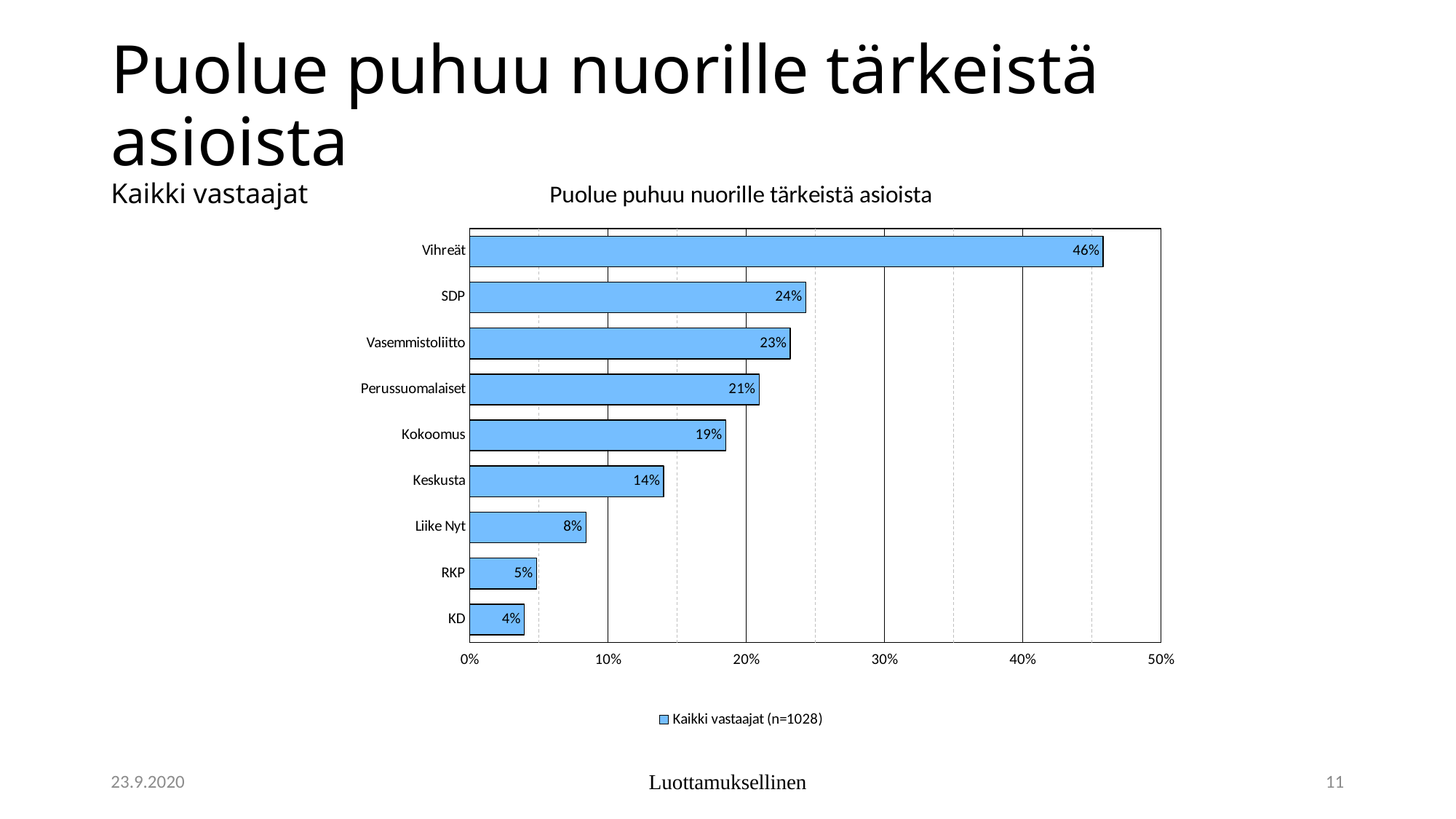
What is the value for Kokoomus? 19% What is the value for Vihreät? 46% What is the difference between the values for SDP and Keskusta? 10% Which party has the highest value? Vihreät What kind of chart is shown on the slide? Bar chart Is the value for Vasemmistoliitto greater or less than 20%? greater Which has a larger value, Perussuomalaiset or RKP? Perussuomalaiset How many parties are shown in the chart? 9 What is the value for Liike Nyt? 8% What is the legend entry of the chart? Kaikki vastaajat (n=1028) How many series does the legend list? 1 Which party has the lowest value? KD